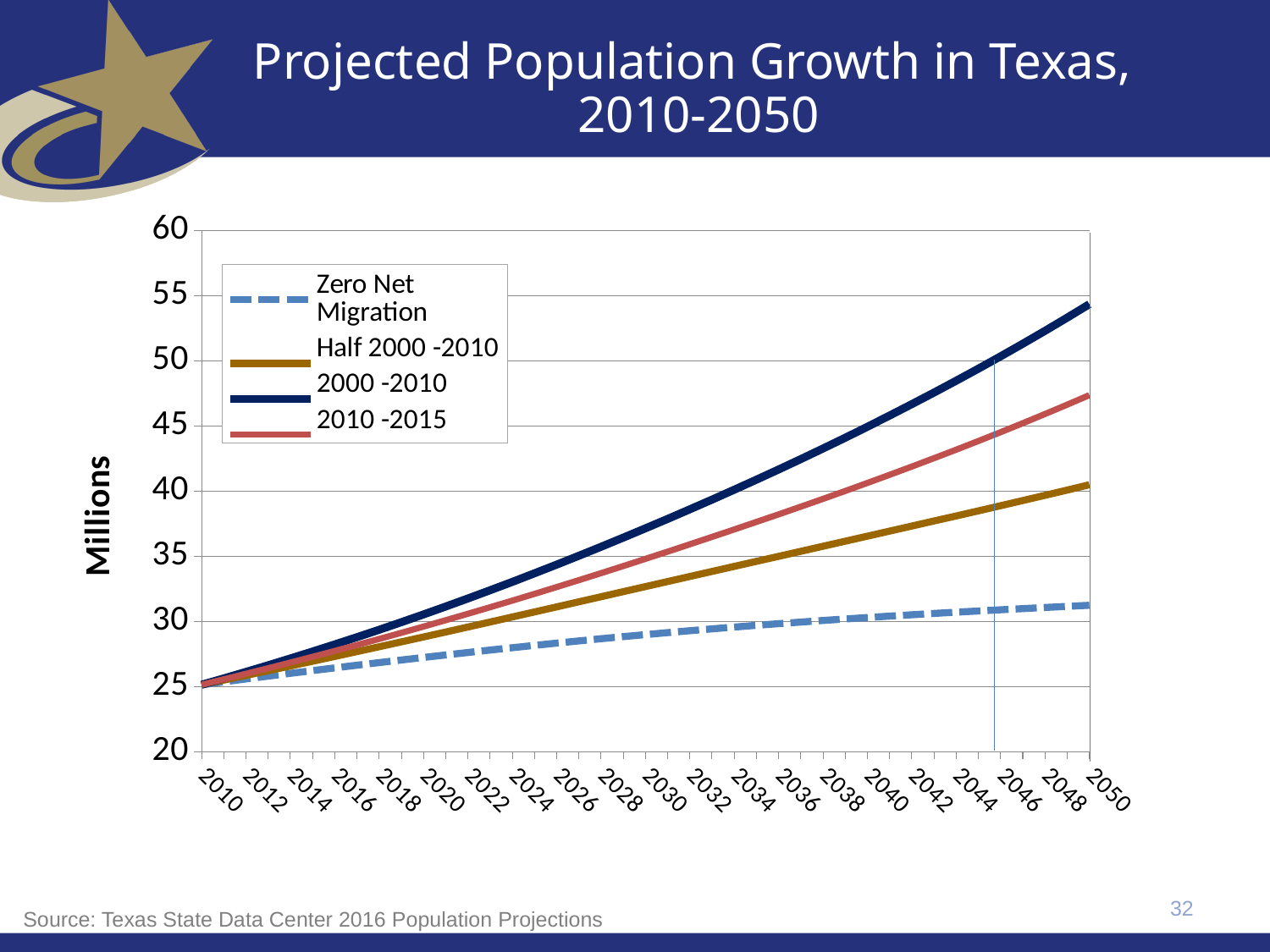
What is the title of the chart? Projected Population Growth in Texas, 2010-2050 Which series has the lowest value in 2050? Zero Net Migration How many year labels are shown on the x axis? 21 Does the 2000 -2010 series rise or fall from 2010 to 2050? rise Is the value for the 2000 -2010 series in 2050 greater or less than 50? greater What kind of chart is shown on the slide? line chart How many series does the legend list? 4 Is the value for the Half 2000 -2010 series in 2050 greater or less than 45? less Which series has the highest value in 2050? 2000 -2010 Which series is drawn with a dashed line? Zero Net Migration In 2050, which is larger: the 2010 -2015 series or the Half 2000 -2010 series? 2010 -2015 Is the value for the Zero Net Migration series in 2050 greater or less than 35? less